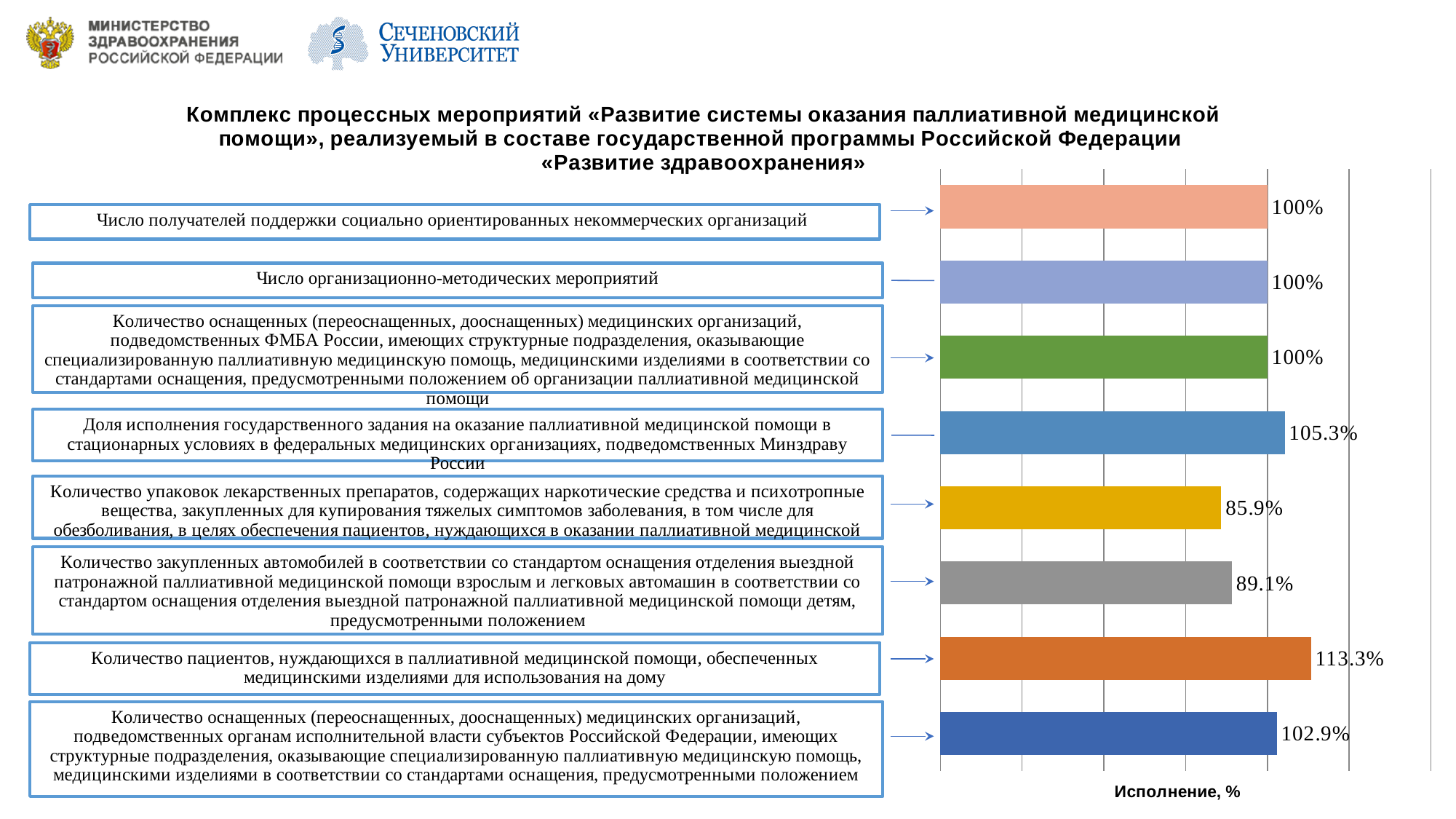
Which indicator has the highest value on the chart? Количество пациентов, нуждающихся в паллиативной медицинской помощи, обеспеченных медицинскими изделиями для использования на дому What is the label shown under the horizontal axis of the chart? Исполнение, % What is the value shown for «Число организационно-методических мероприятий»? 100% What is the value shown for «Доля исполнения государственного задания на оказание паллиативной медицинской помощи в стационарных условиях в федеральных медицинских организациях, подведомственных Минздраву России»? 105.3% What is the difference between the value for «Количество закупленных автомобилей…» (89.1%) and the value for «Количество упаковок лекарственных препаратов…» (85.9%)? 3.2 percentage points What kind of chart is shown on the slide? Bar chart Which indicator has the lowest value on the chart? Количество упаковок лекарственных препаратов, содержащих наркотические средства и психотропные вещества What is the value shown for the bar about «Количество закупленных автомобилей в соответствии со стандартом оснащения отделения выездной патронажной паллиативной медицинской помощи»? 89.1% Which is larger: the value for «Доля исполнения государственного задания…» or the value for the bottom bar «Количество оснащенных … медицинских организаций, подведомственных органам исполнительной власти субъектов Российской Федерации»? Доля исполнения государственного задания… (105.3%) What is the difference between the highest value (113.3%) and the value for the bottom bar (102.9%)? 10.4 percentage points How many bars are plotted on the chart? 8 What is the value shown for «Количество пациентов, нуждающихся в паллиативной медицинской помощи, обеспеченных медицинскими изделиями для использования на дому»? 113.3%